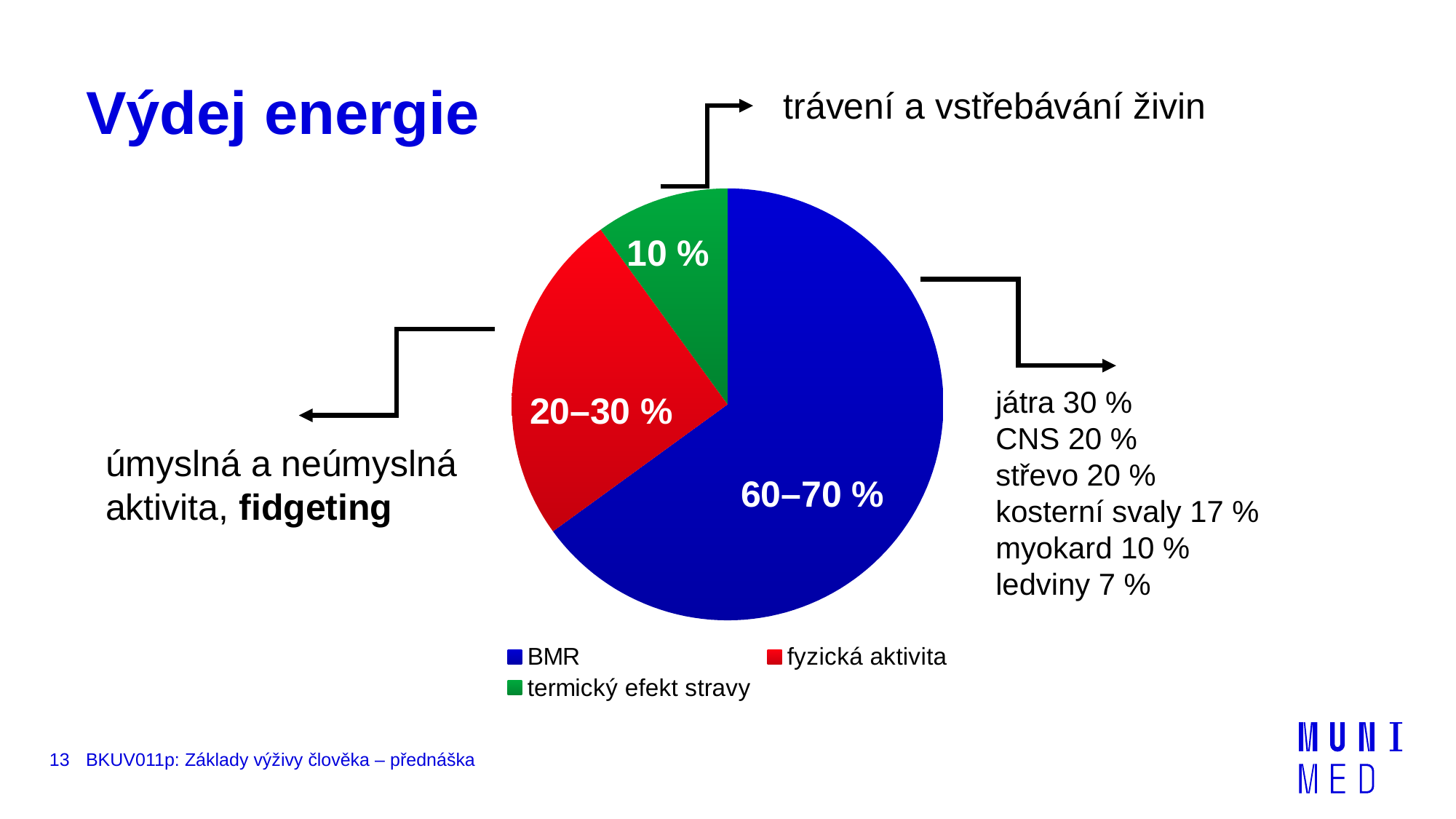
Which category is shown in green in the pie chart? termický efekt stravy What is the data label on the fyzická aktivita slice of the pie chart? 20–30 % What kind of chart is shown on the slide? pie chart Which category has the largest slice of the pie chart? BMR What is the data label on the BMR slice of the pie chart? 60–70 % How many slices does the pie chart have? 3 What colour is the BMR slice in the pie chart? blue Which slice is larger in the pie chart, BMR or fyzická aktivita? BMR What is the data label on the termický efekt stravy slice of the pie chart? 10 % Which slice is larger in the pie chart, fyzická aktivita or termický efekt stravy? fyzická aktivita Which category has the smallest slice of the pie chart? termický efekt stravy How many entries does the legend of the pie chart list? 3